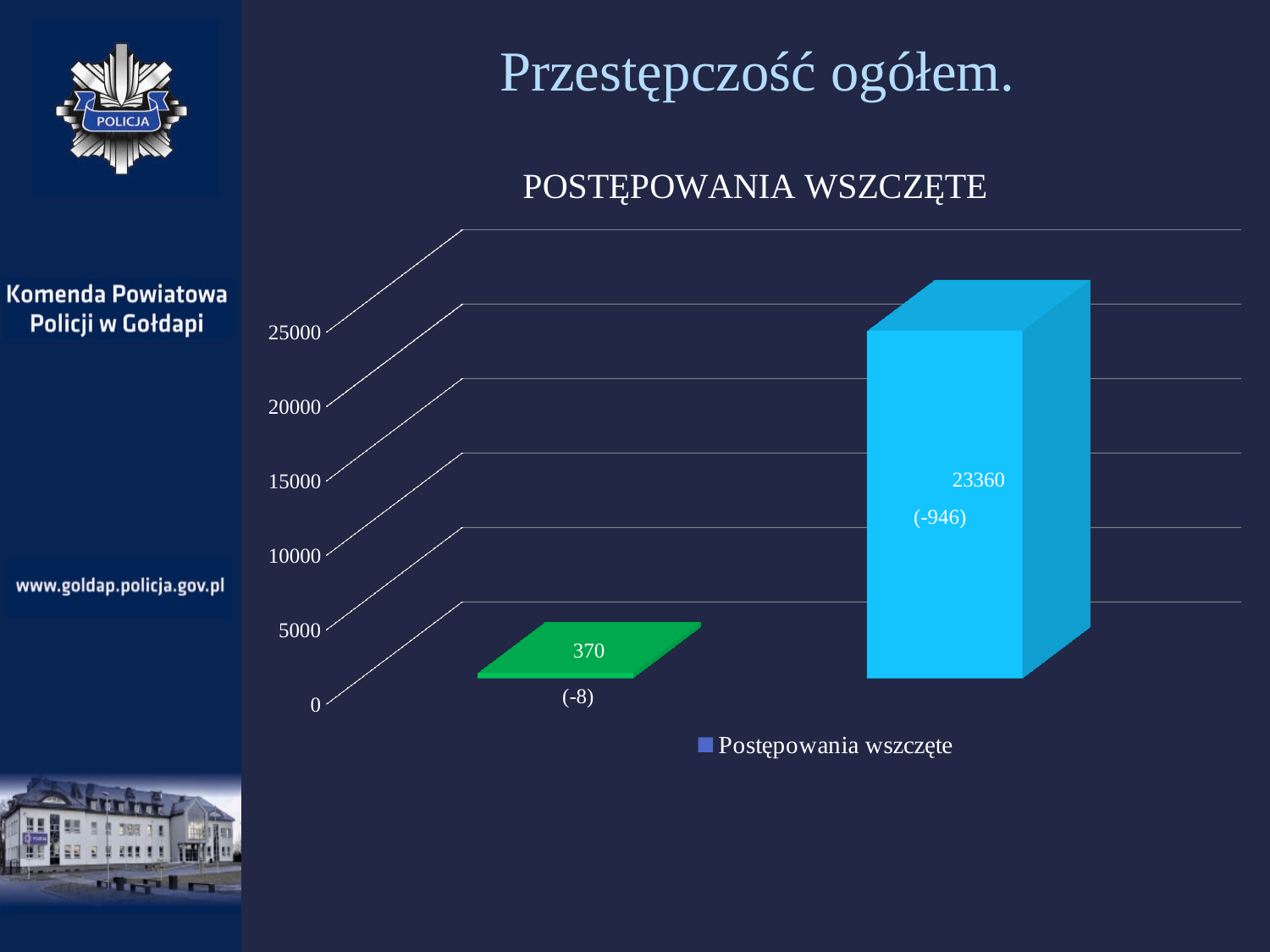
What is the value shown on the green bar? 370 How many bars are plotted in the chart? 2 What change figure is printed in parentheses on the blue bar? (-946) What is the title of the chart? POSTĘPOWANIA WSZCZĘTE What kind of chart is shown on the slide? bar chart What is the value shown on the blue bar? 23360 How many series does the legend list? 1 What change figure is printed in parentheses below the green bar? (-8) What is the difference between the value of the blue bar and the value of the green bar? 22990 Which bar has the highest value, the green one or the blue one? the blue bar Which bar has the lowest value, the green one or the blue one? the green bar Is the value of the blue bar greater or less than 20000? greater